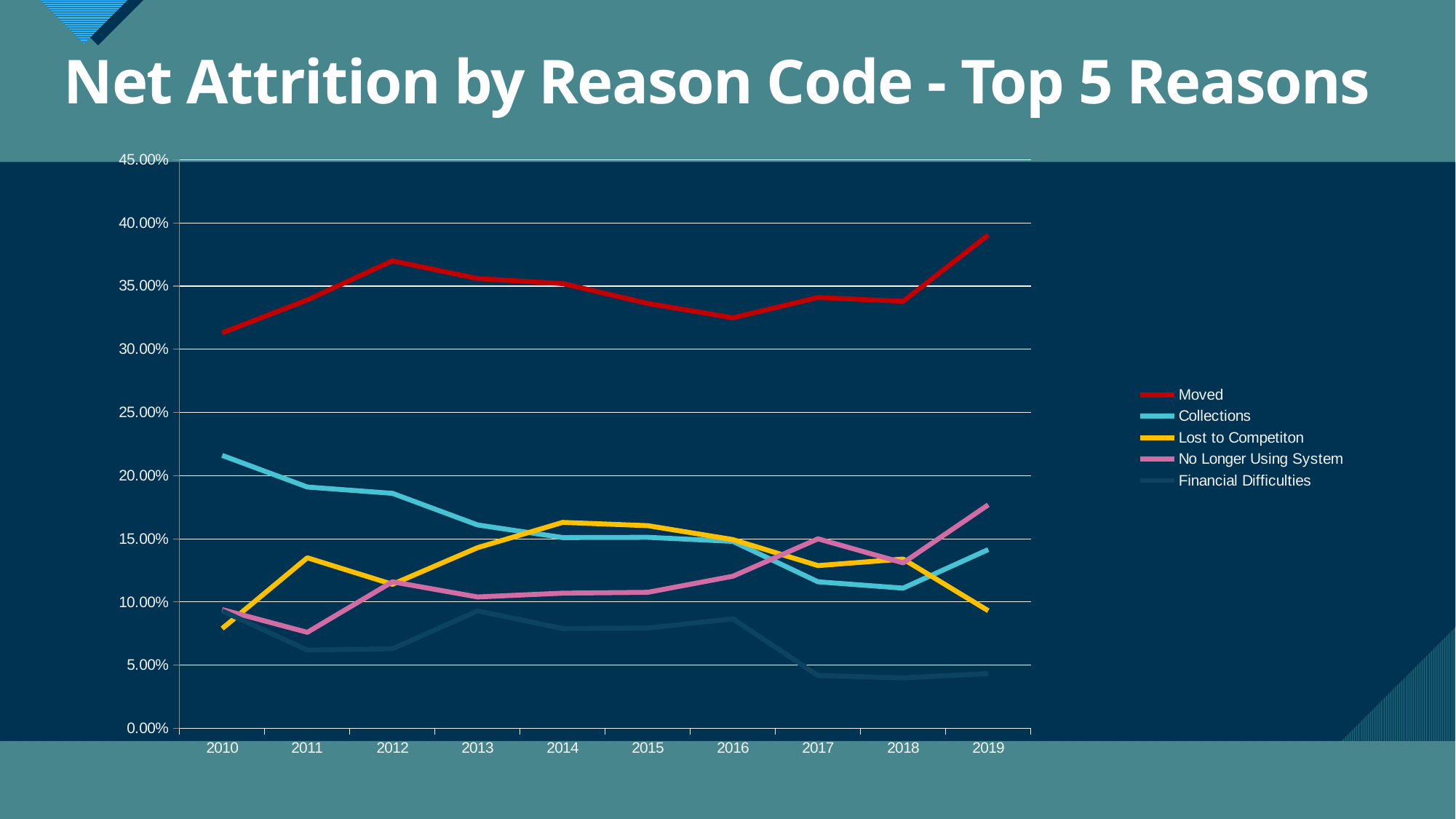
Is the value for Collections in 2010 greater or less than 20.00%? greater Is the value for Financial Difficulties in 2018 greater or less than 5.00%? less What colour is the line for Moved? red In 2019, which is larger: No Longer Using System or Lost to Competiton? No Longer Using System Does the Collections line rise or fall from 2010 to 2018? fall What kind of chart is shown on the slide? line chart How many years are shown on the x axis? 10 Which reason code has the lowest net attrition in 2019? Financial Difficulties Which reason code has the highest net attrition in 2019? Moved How many series does the legend list? 5 In which year is the value for Moved highest? 2019 Is the value for Moved in 2019 greater or less than 35.00%? greater